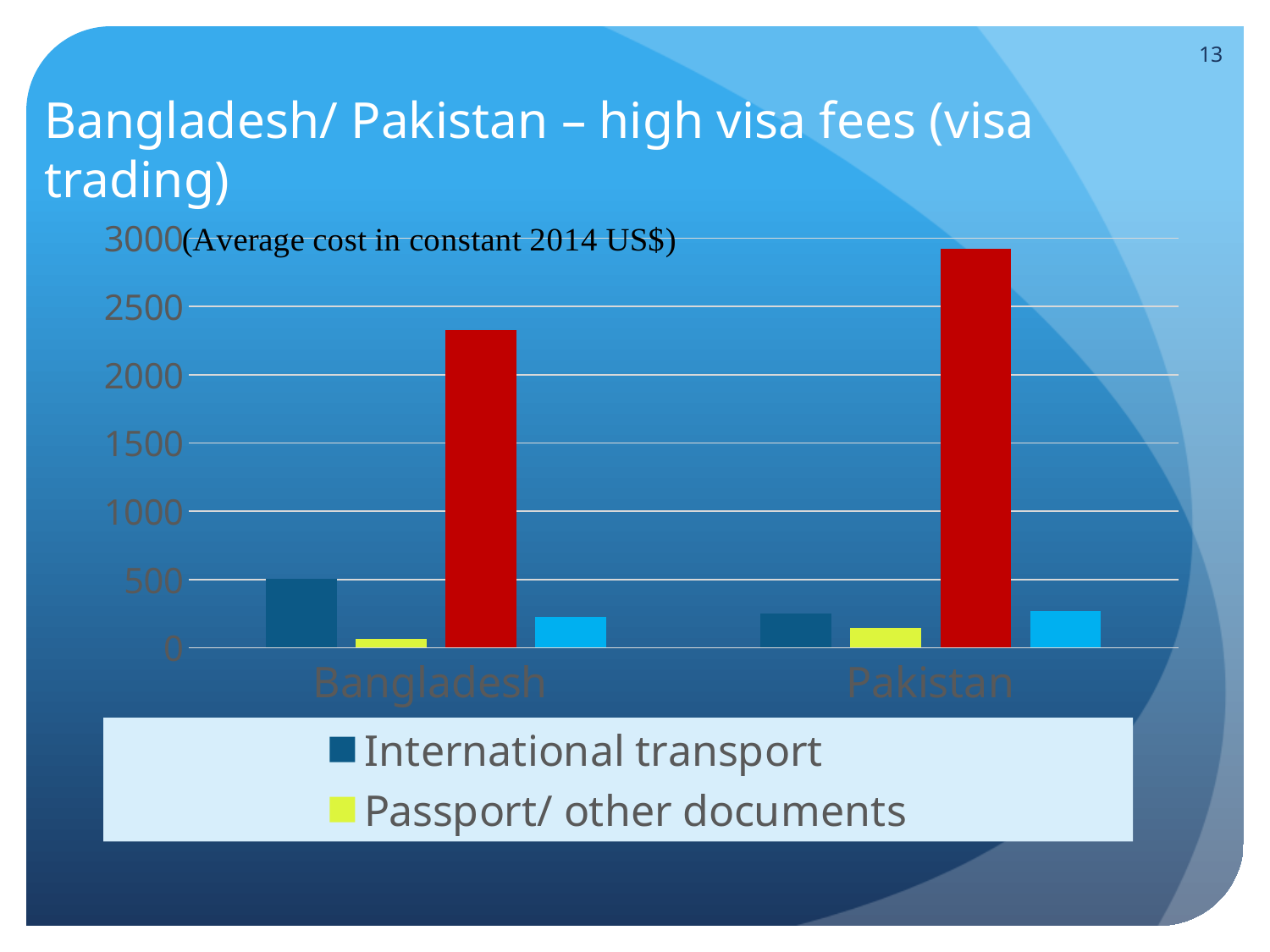
Is the value for International transport in Bangladesh greater or less than 1000? less Which country has the higher value for International transport? Bangladesh How many series does the chart's legend list? 2 How many countries are shown on the x axis of the chart? 2 Which country has the higher value for Passport/ other documents? Pakistan What unit does the chart's subtitle say the costs are measured in? constant 2014 US$ What kind of chart is shown on the slide? bar chart Is the value for Passport/ other documents in Bangladesh greater or less than 500? less Is the value for International transport in Pakistan greater or less than 500? less Which country contains the tallest bar in the chart? Pakistan